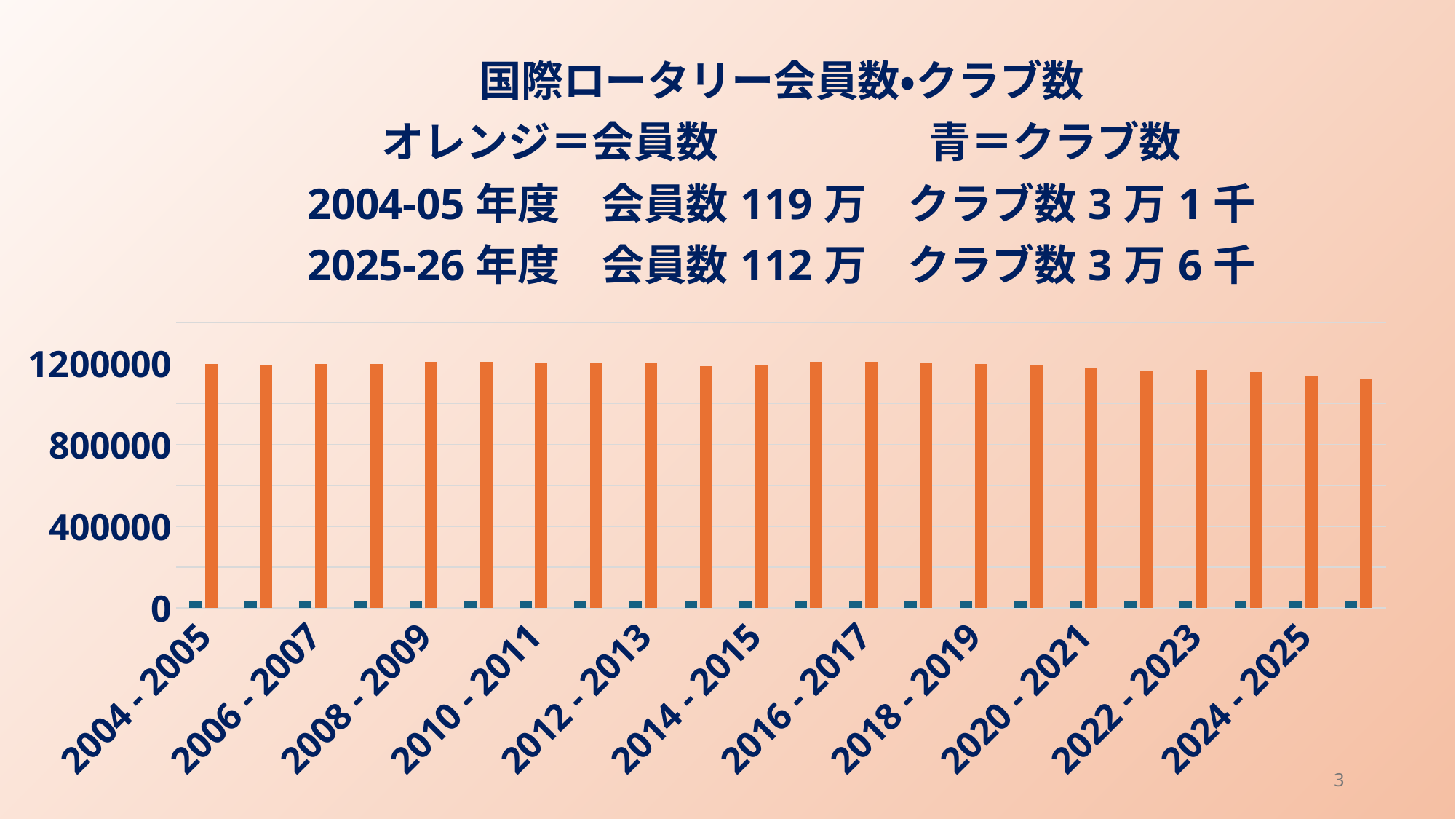
How many data series are plotted in the chart? 2 Is the orange bar for 2024 - 2025 greater or less than 1200000? less Is the orange bar for 2004 - 2005 greater or less than 800000? greater What is the title of the chart on the slide? 国際ロータリー会員数•クラブ数 Among the labeled years, which has the lowest orange bar? 2024 - 2025 Do the orange bars rise or fall from 2018 - 2019 to 2024 - 2025? fall Is the blue bar for 2012 - 2013 greater or less than 400000? less How many year labels are shown on the x axis? 11 Which is larger for 2016 - 2017, the orange bar or the blue bar? the orange bar According to the slide text, what does the orange colour represent? 会員数 Which is larger, the orange bar for 2004 - 2005 or the orange bar for 2024 - 2025? 2004 - 2005 What kind of chart is shown on the slide? bar chart